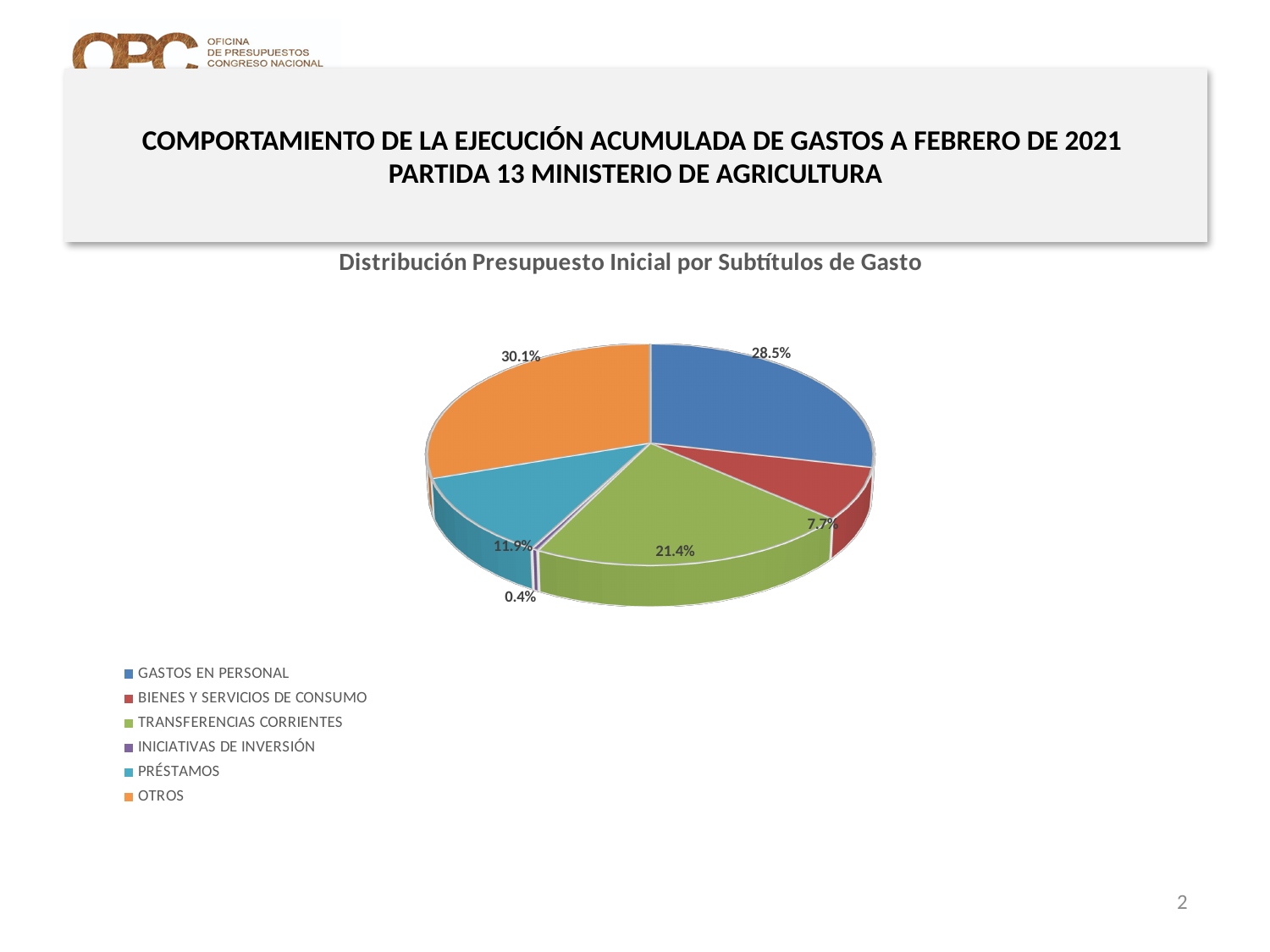
Which category has the largest share of the pie? OTROS What share of the pie does TRANSFERENCIAS CORRIENTES represent? 21.4% What kind of chart is shown on the slide? Pie chart What share of the pie does PRÉSTAMOS represent? 11.9% What share of the pie does GASTOS EN PERSONAL represent? 28.5% What is the difference in percentage points between GASTOS EN PERSONAL and TRANSFERENCIAS CORRIENTES? 7.1 How many categories does the legend list? 6 What is the title of the chart? Distribución Presupuesto Inicial por Subtítulos de Gasto Which category has the smallest share of the pie? INICIATIVAS DE INVERSIÓN